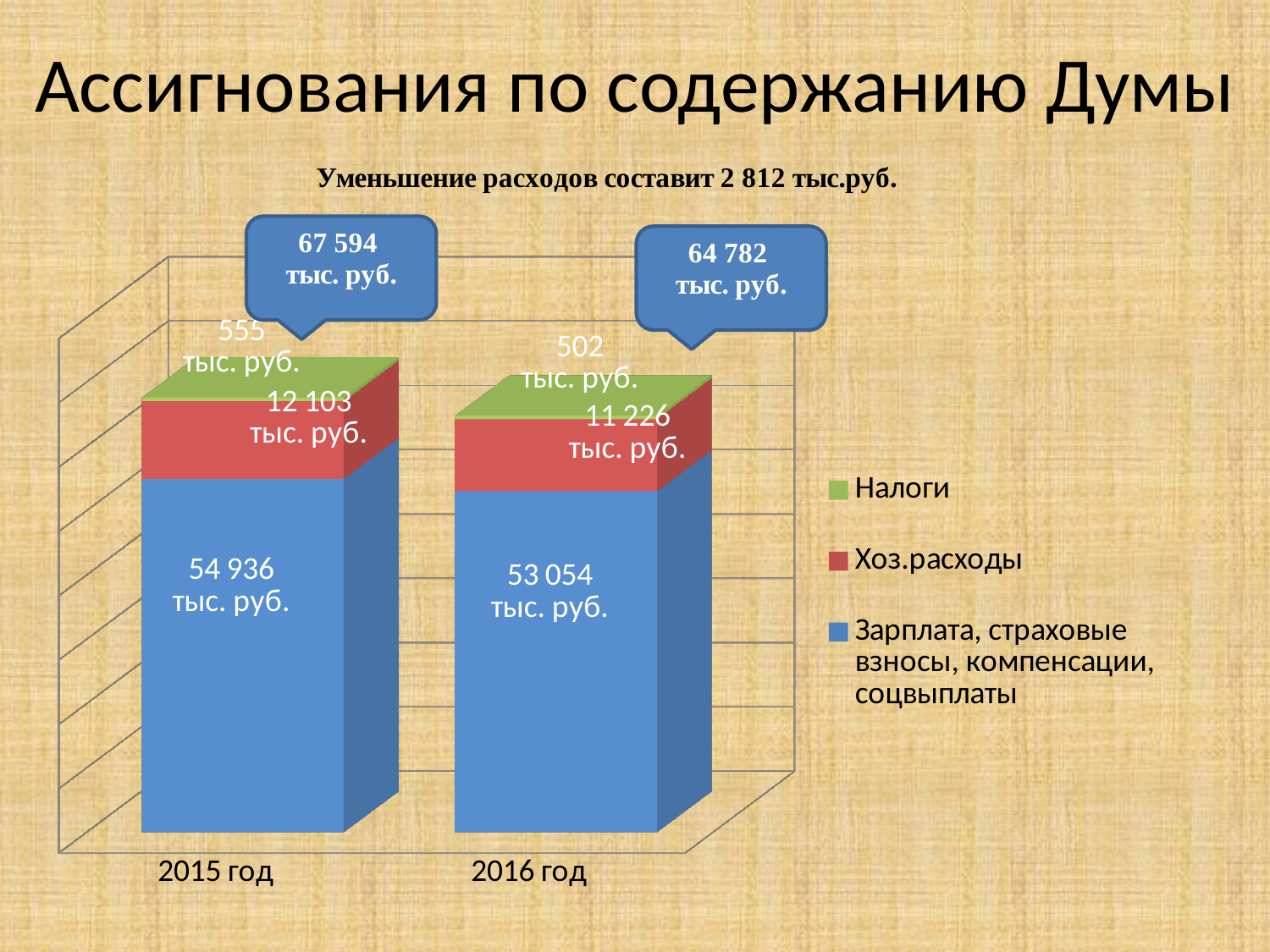
How many series does the legend list? 3 What is the value for Налоги in 2016 год? 502 тыс. руб. Which colour represents Налоги in the legend? Green What is the value for Хоз.расходы in 2016 год? 11 226 тыс. руб. What is the value for Налоги in 2015 год? 555 тыс. руб. What kind of chart is shown on the slide? Stacked bar chart What is the value for Зарплата, страховые взносы, компенсации, соцвыплаты in 2015 год? 54 936 тыс. руб. What is the total of the stacked bar for 2015 год? 67 594 тыс. руб. What is the total of the stacked bar for 2016 год? 64 782 тыс. руб. What is the difference between the Хоз.расходы values for 2015 год and 2016 год? 877 тыс. руб. Which year has the larger value for Зарплата, страховые взносы, компенсации, соцвыплаты, 2015 год or 2016 год? 2015 год How many categories are shown on the x axis? 2